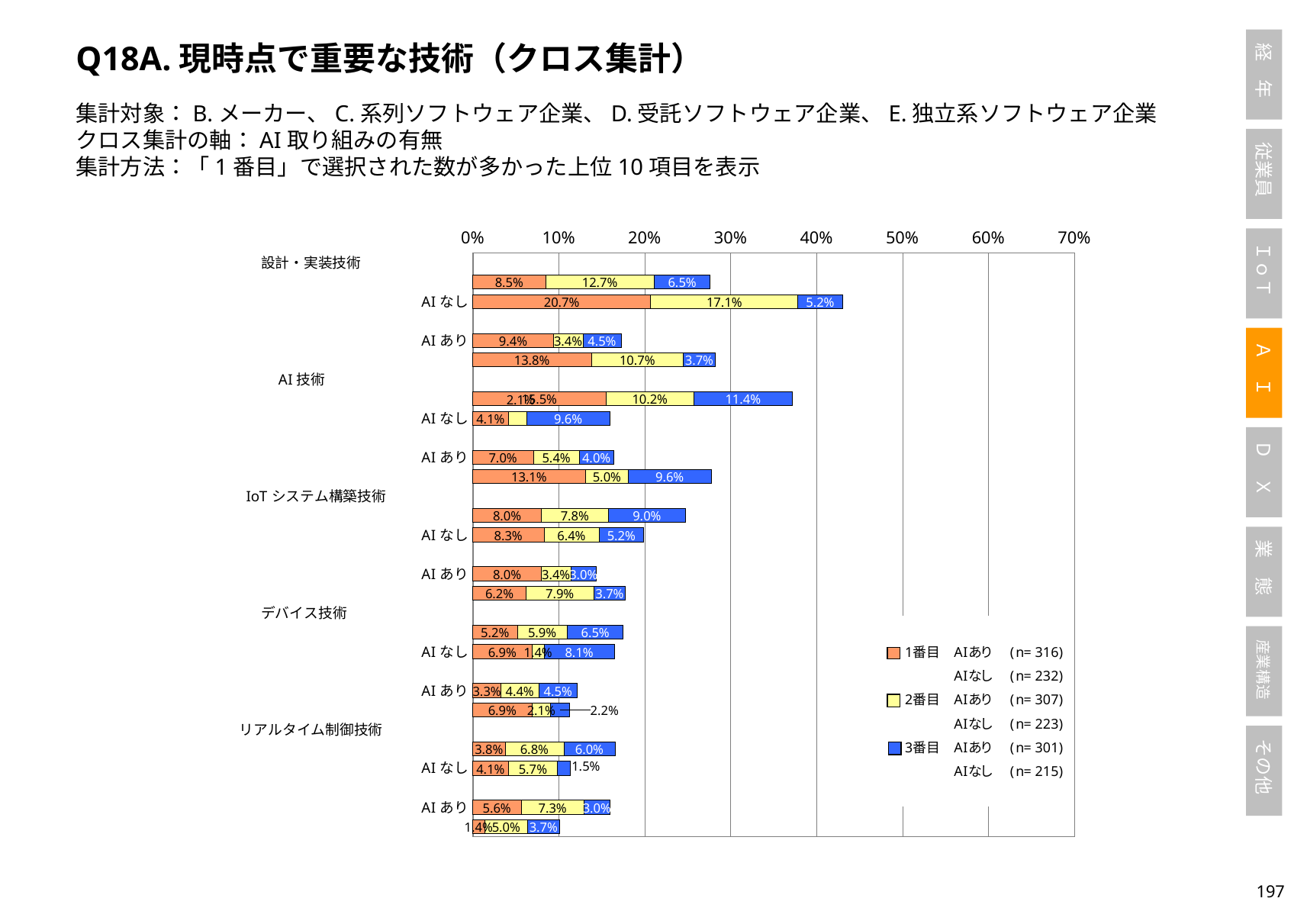
What are the three series names in the legend? 1番目, 2番目, 3番目 What is the largest 1番目 (orange) value printed on the chart? 20.7% How many series does the legend list? 3 According to the legend, what is the n for AIあり in the 1番目 series? 316 What is the total of the second bar from the top (20.7%, 17.1%, 5.2%)? 43.0% What is the 3番目 (blue) value in the bottommost bar? 3.7% What kind of chart is shown on the slide? stacked bar chart Which is larger: the 1番目 value in the second bar from the top (20.7%) or the 1番目 value in the topmost bar (8.5%)? 20.7% What is the total of the topmost bar (8.5%, 12.7%, 6.5%)? 27.7% Is the total of the second bar from the top greater or less than 40%? greater What is the difference between the 1番目 value in the second bar from the top (20.7%) and the 1番目 value in the topmost bar (8.5%)? 12.2% What is the 2番目 (yellow) value in the second bar from the top? 17.1%